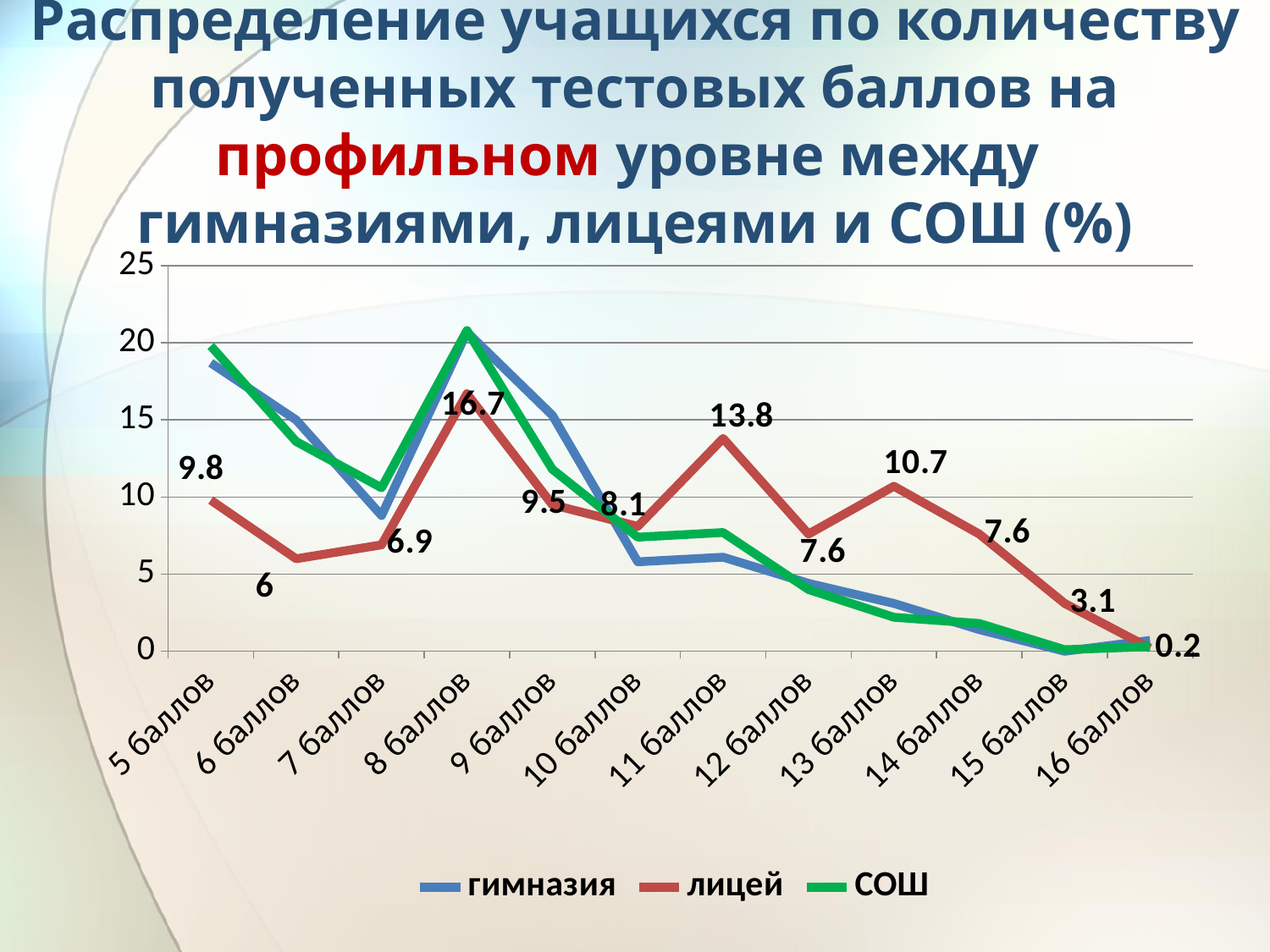
Which is larger for лицей: the value at 11 баллов or at 13 баллов? 11 баллов What is the difference between the лицей values at 8 баллов and 5 баллов? 6.9 Is the value for гимназия at 5 баллов greater or less than 15? greater How many series does the legend list? 3 What kind of chart is shown on the slide? line chart At which score category does the лицей series have its lowest value? 16 баллов What is the value for лицей at 16 баллов? 0.2 At which score category does the лицей series reach its highest value? 8 баллов How many score categories are shown on the x axis? 12 What is the value for лицей at 5 баллов? 9.8 What is the value for лицей at 11 баллов? 13.8 Is the value for гимназия at 7 баллов greater or less than 10? less